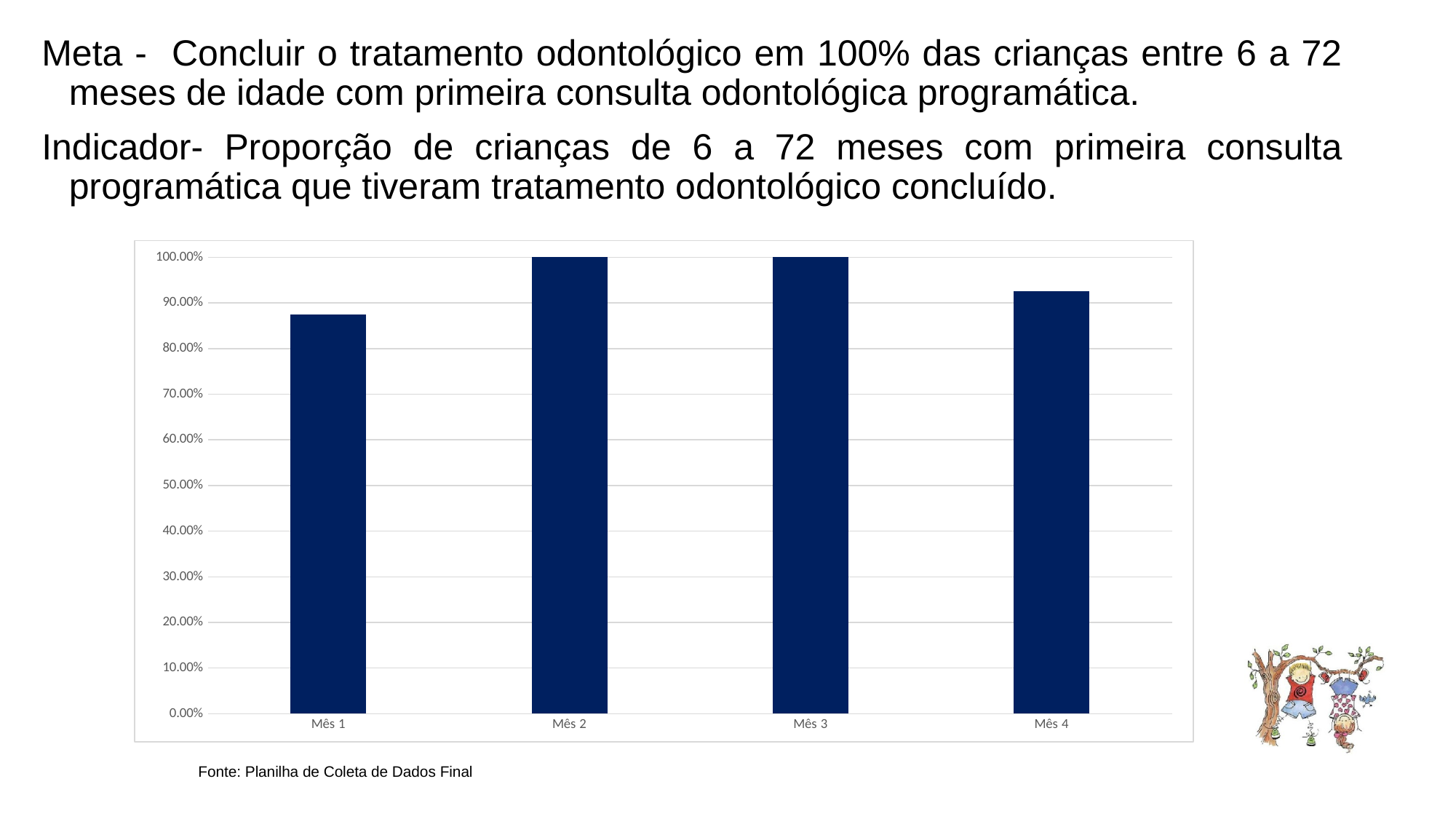
Is the value for Mês 4 greater or less than 90.00%? greater Which is larger, the value for Mês 1 or the value for Mês 4? Mês 4 Is the value for Mês 1 greater or less than 90.00%? less What is the value for Mês 3? 100.00% Does the value rise or fall from Mês 1 to Mês 2? rise Which month has the lowest value? Mês 1 What source is cited below the chart? Planilha de Coleta de Dados Final Is the value for Mês 1 greater or less than 80.00%? greater What kind of chart is shown on the slide? bar chart What is the value for Mês 2? 100.00% How many categories (months) are plotted on the chart? 4